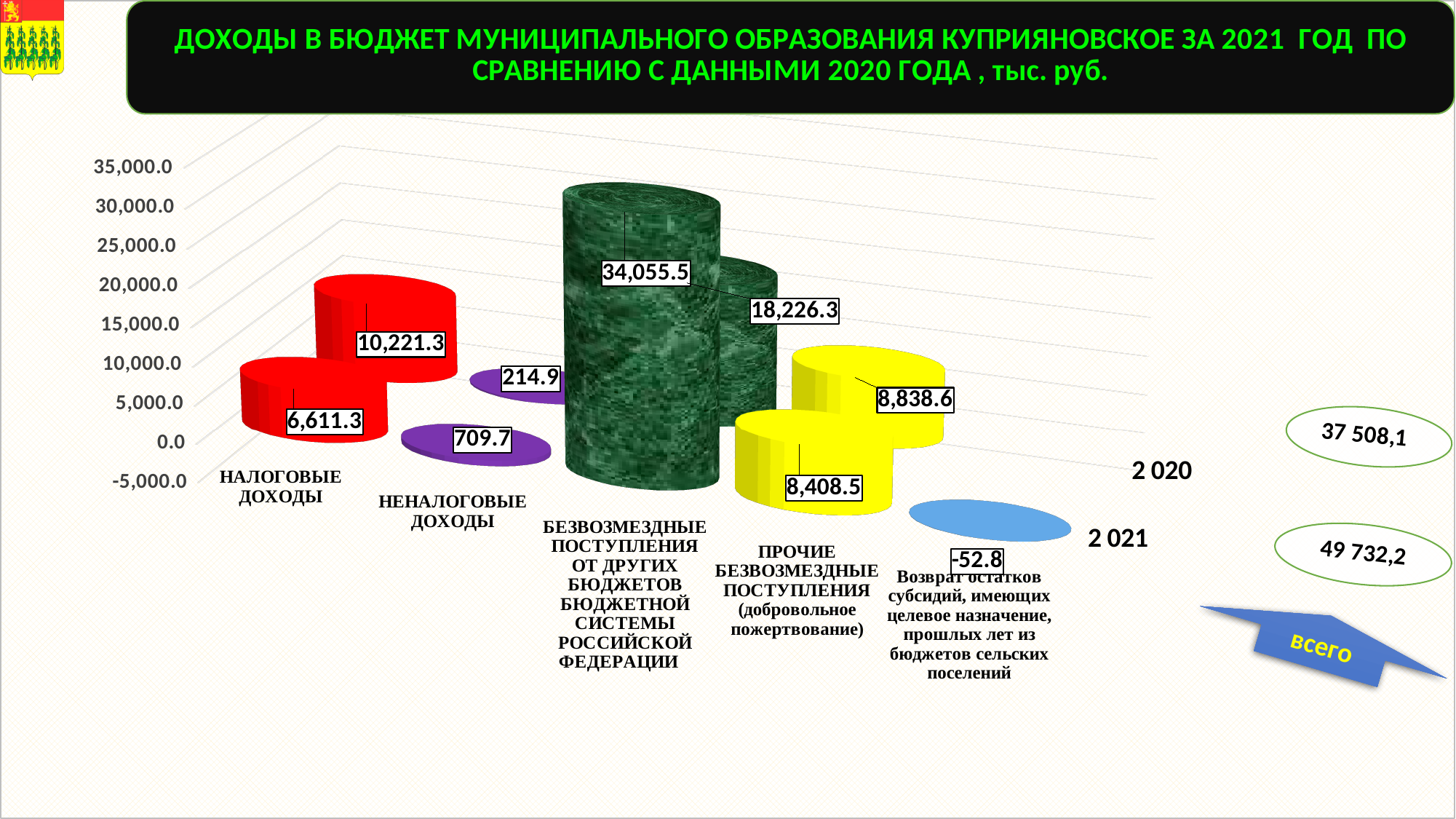
What is the difference between the 2020 and 2021 values for НАЛОГОВЫЕ ДОХОДЫ? 3,610.0 What is the total income (всего) shown for 2021? 49 732,2 What is the 2020 value for НЕНАЛОГОВЫЕ ДОХОДЫ? 214.9 What is the 2020 value for НАЛОГОВЫЕ ДОХОДЫ? 10,221.3 What is the difference between the 2021 and 2020 values for БЕЗВОЗМЕЗДНЫЕ ПОСТУПЛЕНИЯ ОТ ДРУГИХ БЮДЖЕТОВ? 15,829.2 Which category has the highest value in 2021? БЕЗВОЗМЕЗДНЫЕ ПОСТУПЛЕНИЯ ОТ ДРУГИХ БЮДЖЕТОВ БЮДЖЕТНОЙ СИСТЕМЫ РОССИЙСКОЙ ФЕДЕРАЦИИ What is the value shown for Возврат остатков субсидий in 2021? -52.8 Which is larger for ПРОЧИЕ БЕЗВОЗМЕЗДНЫЕ ПОСТУПЛЕНИЯ: the 2020 value or the 2021 value? 2020 How many series (years) does the chart show? 2 Which category has the lowest value in 2020? НЕНАЛОГОВЫЕ ДОХОДЫ What is the 2021 value for НАЛОГОВЫЕ ДОХОДЫ? 6,611.3 What is the 2021 value for БЕЗВОЗМЕЗДНЫЕ ПОСТУПЛЕНИЯ ОТ ДРУГИХ БЮДЖЕТОВ БЮДЖЕТНОЙ СИСТЕМЫ РОССИЙСКОЙ ФЕДЕРАЦИИ? 34,055.5